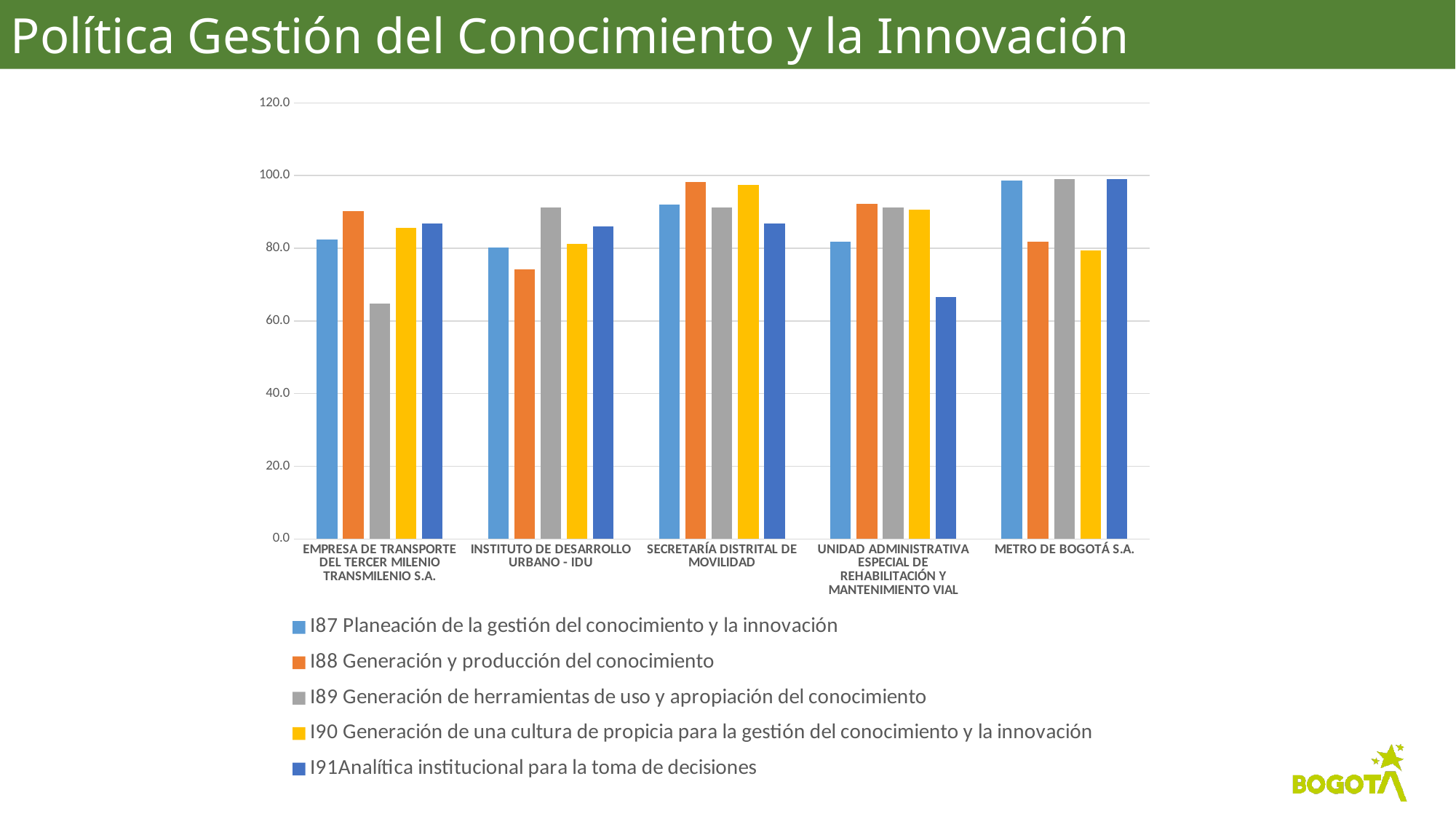
What colour represents I90 Generación de una cultura de propicia para la gestión del conocimiento y la innovación in the legend? Yellow Is the value of I91 Analítica institucional para la toma de decisiones for UNIDAD ADMINISTRATIVA ESPECIAL DE REHABILITACIÓN Y MANTENIMIENTO VIAL greater or less than 80.0? less Is the value of I88 Generación y producción del conocimiento for SECRETARÍA DISTRITAL DE MOVILIDAD greater or less than 80.0? greater Is the value of I88 Generación y producción del conocimiento for INSTITUTO DE DESARROLLO URBANO - IDU greater or less than 80.0? less For EMPRESA DE TRANSPORTE DEL TERCER MILENIO TRANSMILENIO S.A., which is larger: I88 Generación y producción del conocimiento or I89 Generación de herramientas de uso y apropiación del conocimiento? I88 Generación y producción del conocimiento How many entities (categories) are shown on the x axis of the chart? 5 For INSTITUTO DE DESARROLLO URBANO - IDU, which is larger: I88 Generación y producción del conocimiento or I89 Generación de herramientas de uso y apropiación del conocimiento? I89 Generación de herramientas de uso y apropiación del conocimiento How many series does the legend list? 5 Which series has the lowest value for EMPRESA DE TRANSPORTE DEL TERCER MILENIO TRANSMILENIO S.A.? I89 Generación de herramientas de uso y apropiación del conocimiento What kind of chart is shown on the slide? Bar chart Which series has the lowest value for UNIDAD ADMINISTRATIVA ESPECIAL DE REHABILITACIÓN Y MANTENIMIENTO VIAL? I91 Analítica institucional para la toma de decisiones